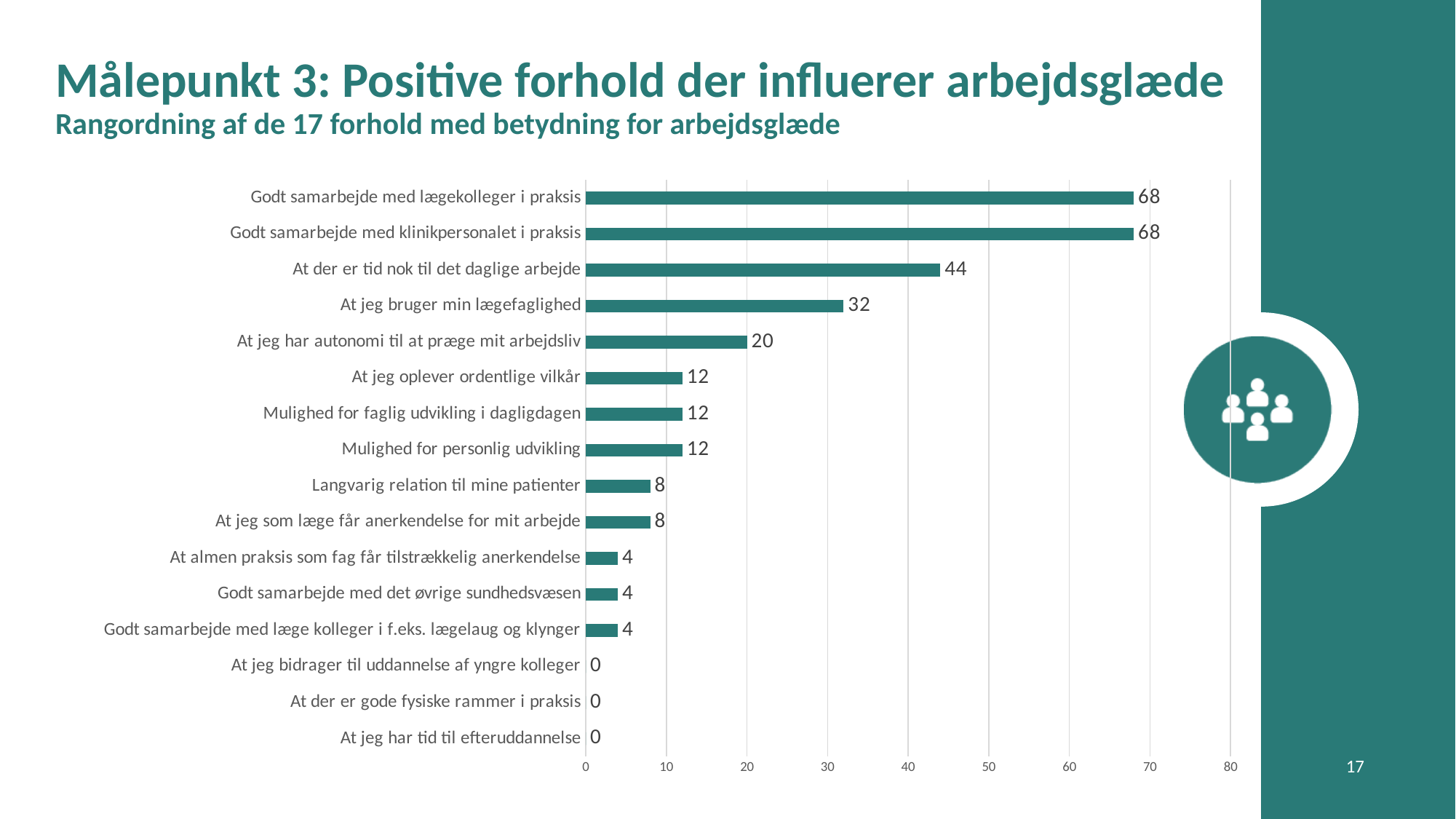
What is the subtitle of the slide above the chart? Rangordning af de 17 forhold med betydning for arbejdsglæde What is the value for "At jeg bruger min lægefaglighed"? 32 What kind of chart is shown on the slide? Bar chart How many categories are shown in the chart? 16 What is the value for "At jeg har autonomi til at præge mit arbejdsliv"? 20 What is the value for "At der er tid nok til det daglige arbejde"? 44 Which has a larger value: "At der er tid nok til det daglige arbejde" or "At jeg bruger min lægefaglighed"? At der er tid nok til det daglige arbejde Is the value for "At jeg har autonomi til at præge mit arbejdsliv" greater or less than 30? less What is the value for "Langvarig relation til mine patienter"? 8 What is the difference between the values for "Godt samarbejde med lægekolleger i praksis" and "At der er tid nok til det daglige arbejde"? 24 What is the value for "At jeg har tid til efteruddannelse"? 0 What is the highest value shown in the chart? 68